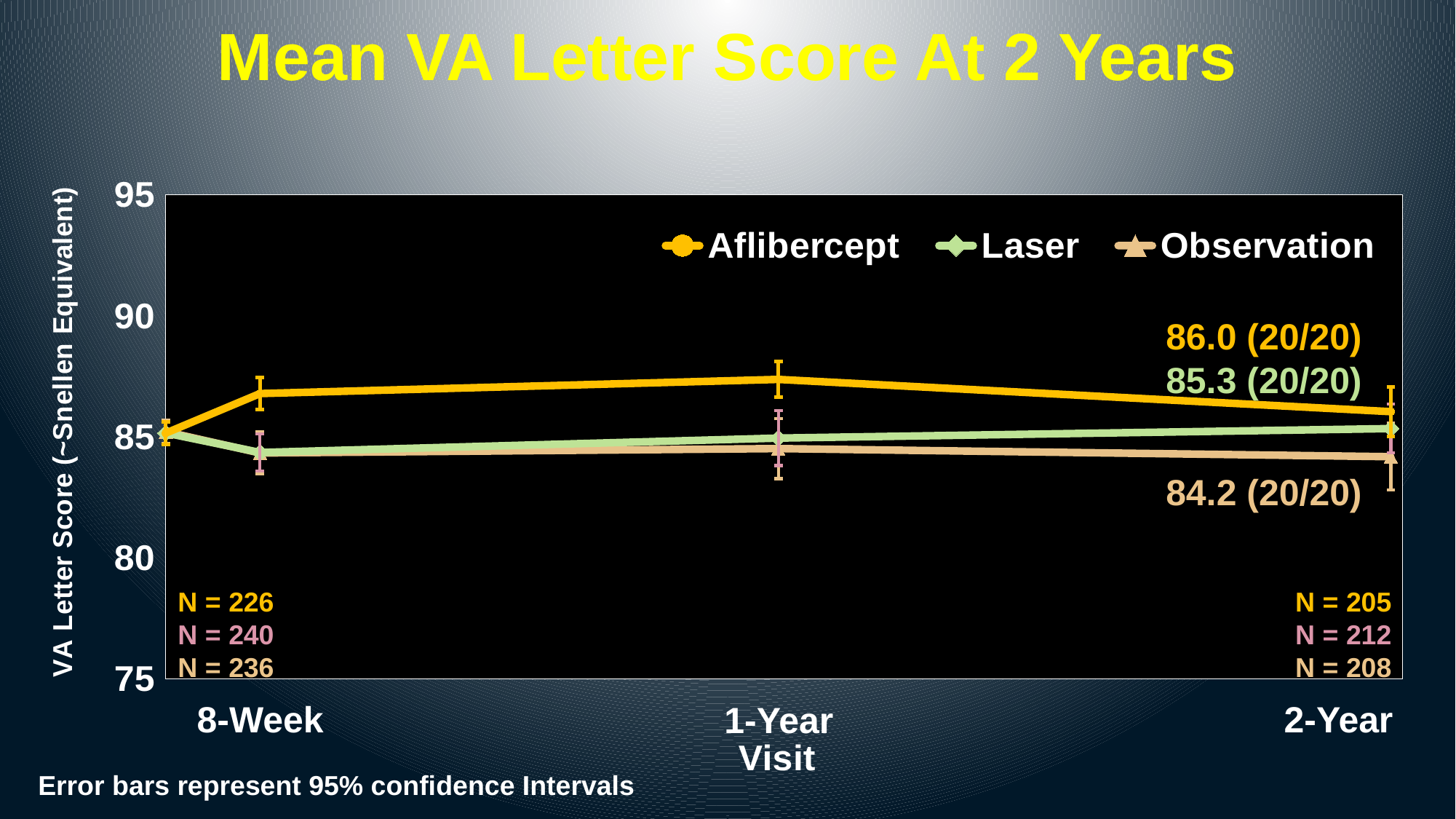
What is the difference between the Aflibercept and Observation mean VA letter scores at 2 years? 1.8 Which group has the lowest mean VA letter score at 2 years? Observation What type of chart is shown on the slide? Line chart Is the Aflibercept value at the 1-Year visit greater or less than 85? greater How many series does the legend list? 3 What is the mean VA letter score for Observation at 2 years? 84.2 What is the title of the chart? Mean VA Letter Score At 2 Years Which group has the highest mean VA letter score at 2 years? Aflibercept What is the mean VA letter score for Laser at 2 years? 85.3 What is the mean VA letter score for Aflibercept at 2 years? 86.0 Does the Aflibercept line rise or fall between the 8-Week and 1-Year visits? Rise